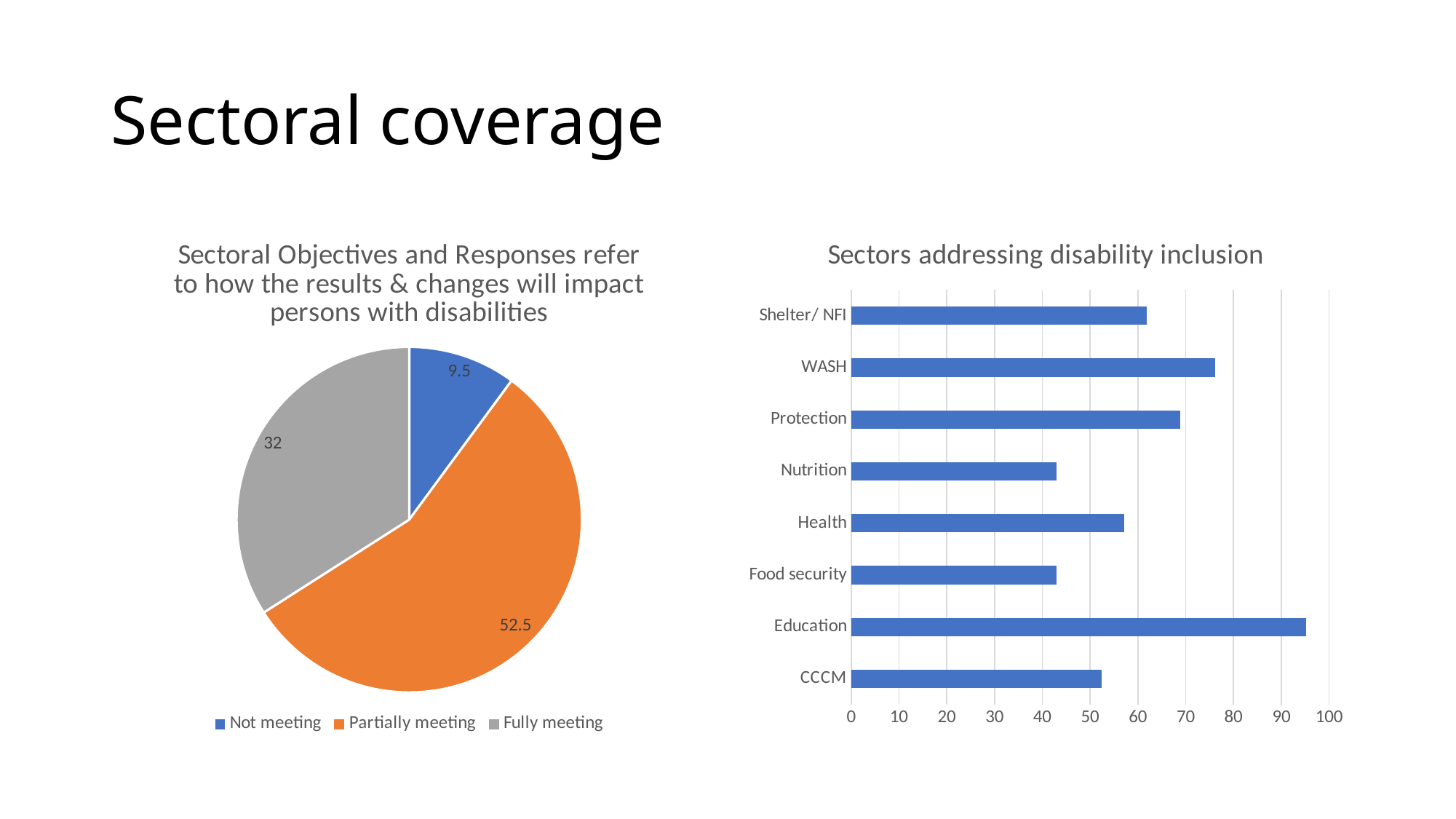
On the pie chart on the left, what is the value for Not meeting? 9.5 On the 'Sectors addressing disability inclusion' chart, which sector has the highest value? Education On the pie chart on the left, what is the value for Fully meeting? 32 On the pie chart on the left, how many categories does the legend list? 3 On the 'Sectors addressing disability inclusion' chart, which has the larger value, WASH or Protection? WASH On the 'Sectors addressing disability inclusion' chart, is the value for Nutrition greater or less than 50? less What kind of chart is the 'Sectors addressing disability inclusion' chart? Bar chart On the pie chart on the left, what is the difference between the values for Partially meeting and Fully meeting? 20.5 On the pie chart on the left, what is the value for Partially meeting? 52.5 On the pie chart on the left, which category has the smallest slice? Not meeting On the 'Sectors addressing disability inclusion' chart, how many sectors are shown? 8 On the pie chart on the left, which category has the largest slice? Partially meeting